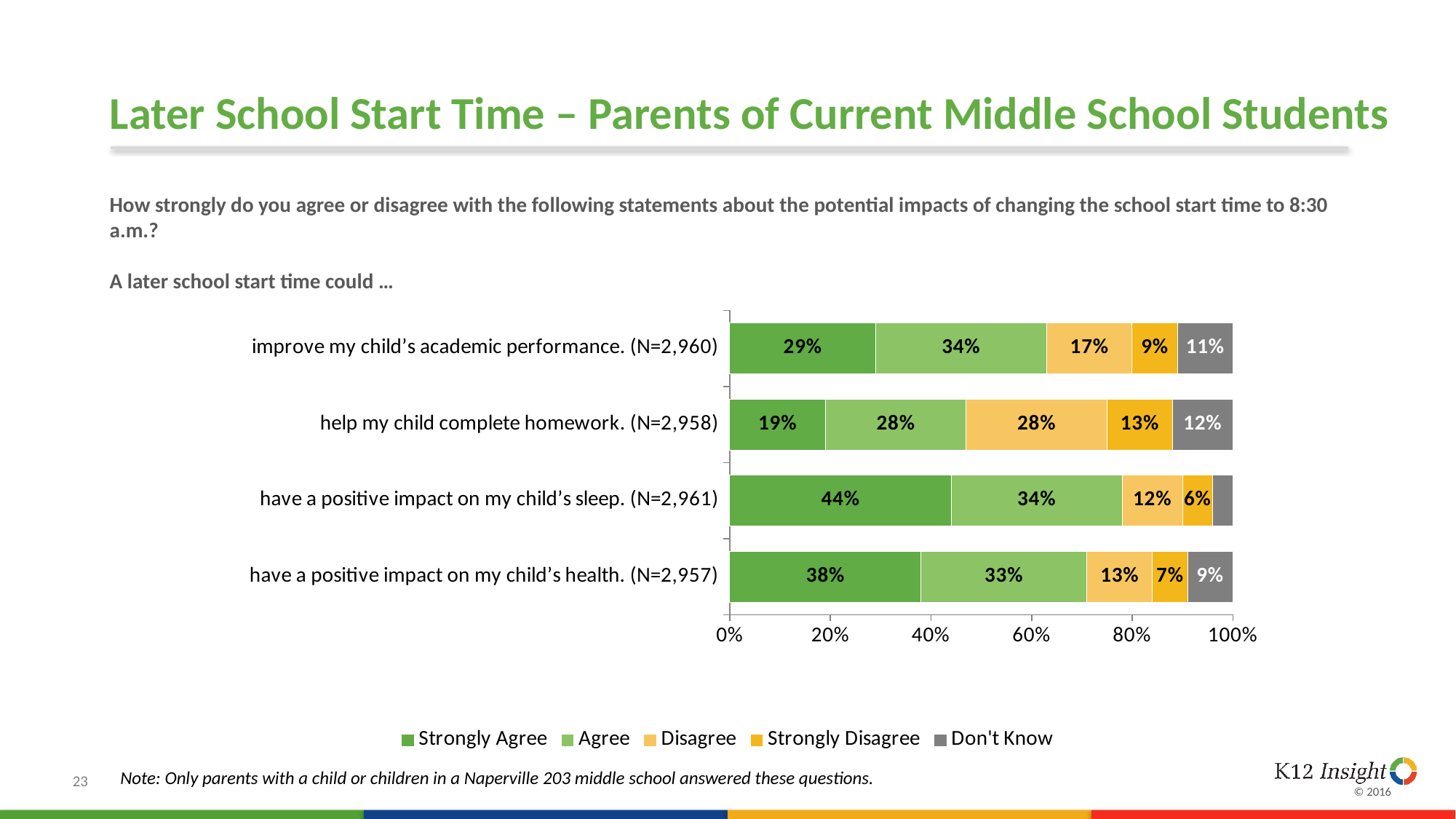
Which statement has a larger Agree percentage: improving academic performance or helping complete homework? improve my child's academic performance Which statement has the highest Strongly Agree percentage? have a positive impact on my child's sleep What percentage of parents disagree that a later school start time could help their child complete homework? 28% What type of chart is shown on the slide? Stacked bar chart How many statements are shown in the chart? 4 How many response categories does the legend list? 5 Which statement has the lowest Strongly Agree percentage? help my child complete homework How many percentage points higher is the Strongly Agree value for the sleep statement than for the health statement? 6 percentage points Is the Don't Know value for the statement about the child's sleep greater or less than 20%? less What is the combined Strongly Agree and Agree percentage for the statement about a positive impact on the child's health? 71% What is the Don't Know percentage for the statement about improving the child's academic performance? 11% What percentage of parents strongly agree that a later school start time could have a positive impact on their child's sleep? 44%